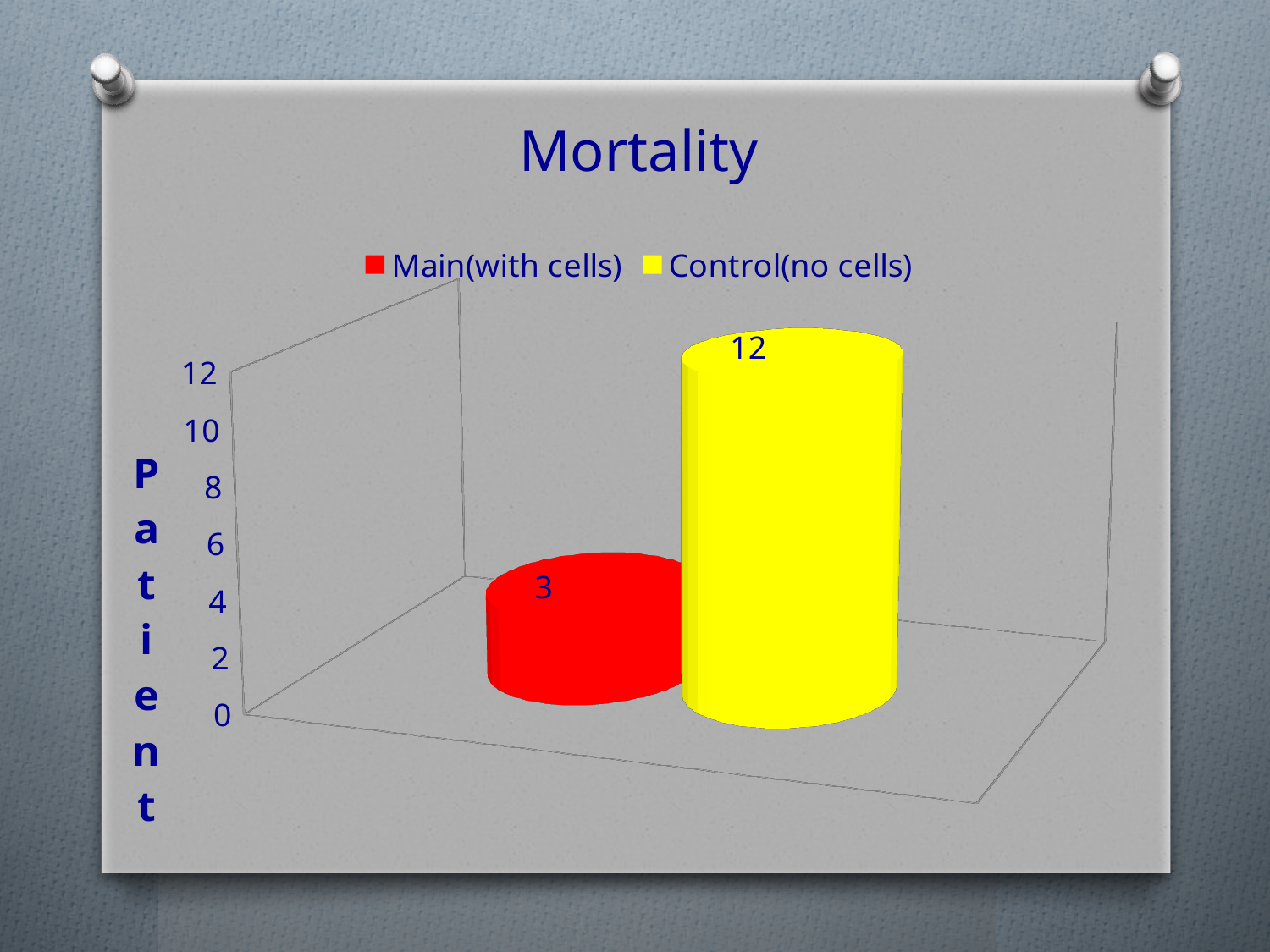
What is the difference between the Control(no cells) value and the Main(with cells) value? 9 What kind of chart is shown on the slide? bar chart Is the value for Main(with cells) greater or less than 6? less Which series has the highest value? Control(no cells) What is the title of the chart? Mortality What colour is the bar for Control(no cells)? yellow How many series does the legend list? 2 Which series has the lowest value? Main(with cells) What is the value for Control(no cells)? 12 What is the value for Main(with cells)? 3 Which is larger, the value for Main(with cells) or the value for Control(no cells)? Control(no cells) Is the value for Control(no cells) greater or less than 10? greater